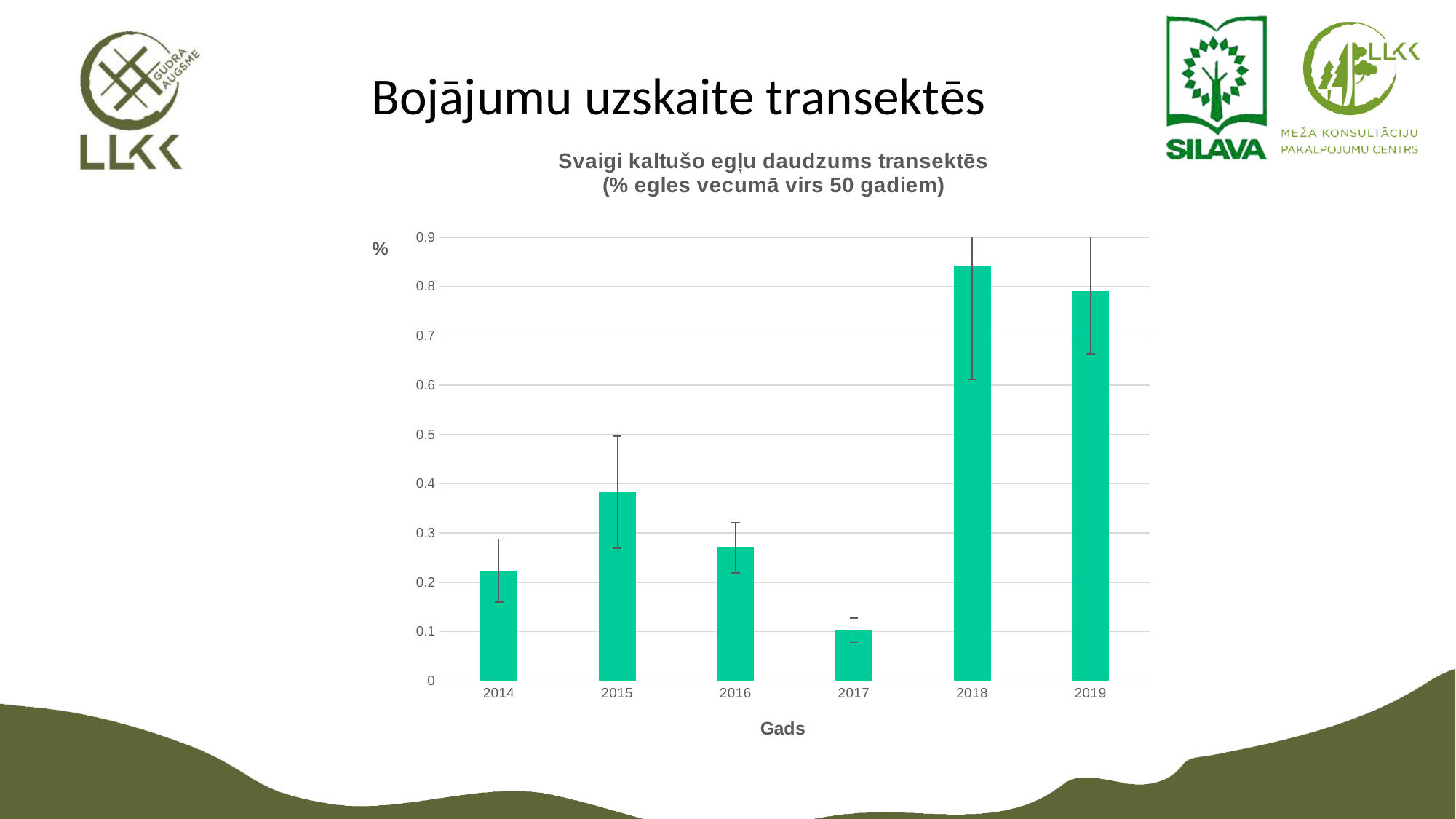
How many years are shown on the x axis of the chart? 6 Do the values rise or fall from 2017 to 2018? rise Which year has the lowest value in the chart? 2017 Is the value for 2017 greater or less than 0.2? less Which year has the larger value, 2015 or 2016? 2015 Is the value for 2018 greater or less than 0.8? greater Which year has the larger value, 2018 or 2017? 2018 What kind of chart is shown on the slide? bar chart Is the value for 2014 greater or less than 0.3? less Which year has the highest value in the chart? 2018 What is the label of the x axis of the chart? Gads